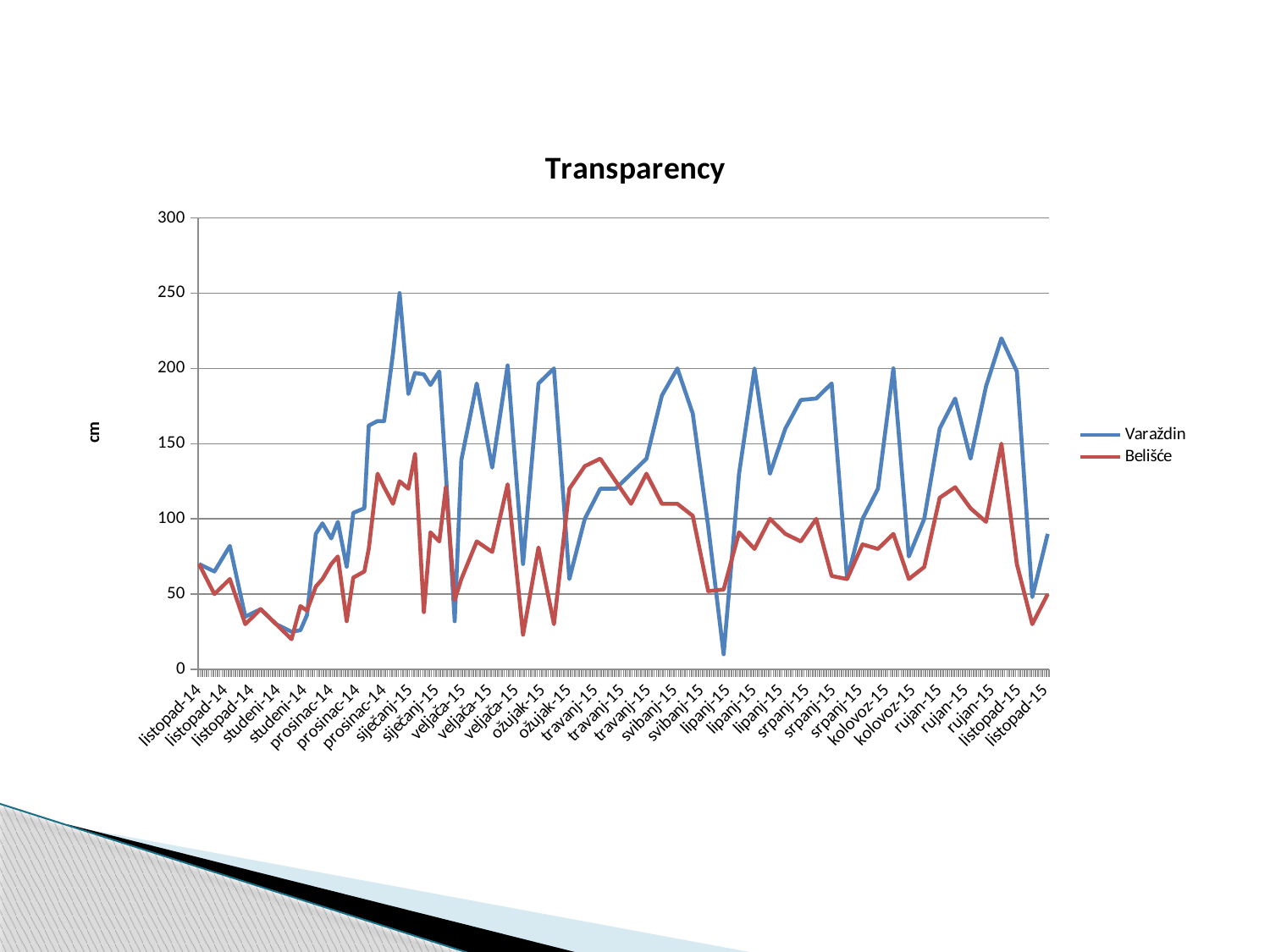
Is the Belišće value at the last point (listopad-15) greater or less than 100? less What are the two series named in the legend of the Transparency chart? Varaždin and Belišće How many series does the legend of the Transparency chart list? 2 Is the highest value reached by the Belišće series greater or less than 200? less What type of chart is shown on the slide? line chart Which series reaches the higher peak value, Varaždin or Belišće? Varaždin What unit is shown on the vertical axis of the Transparency chart? cm Is the Varaždin value at the first point (listopad-14) greater or less than 100? less What is the maximum value shown on the vertical axis of the Transparency chart? 300 Around siječanj-15, which series has the higher value, Varaždin or Belišće? Varaždin